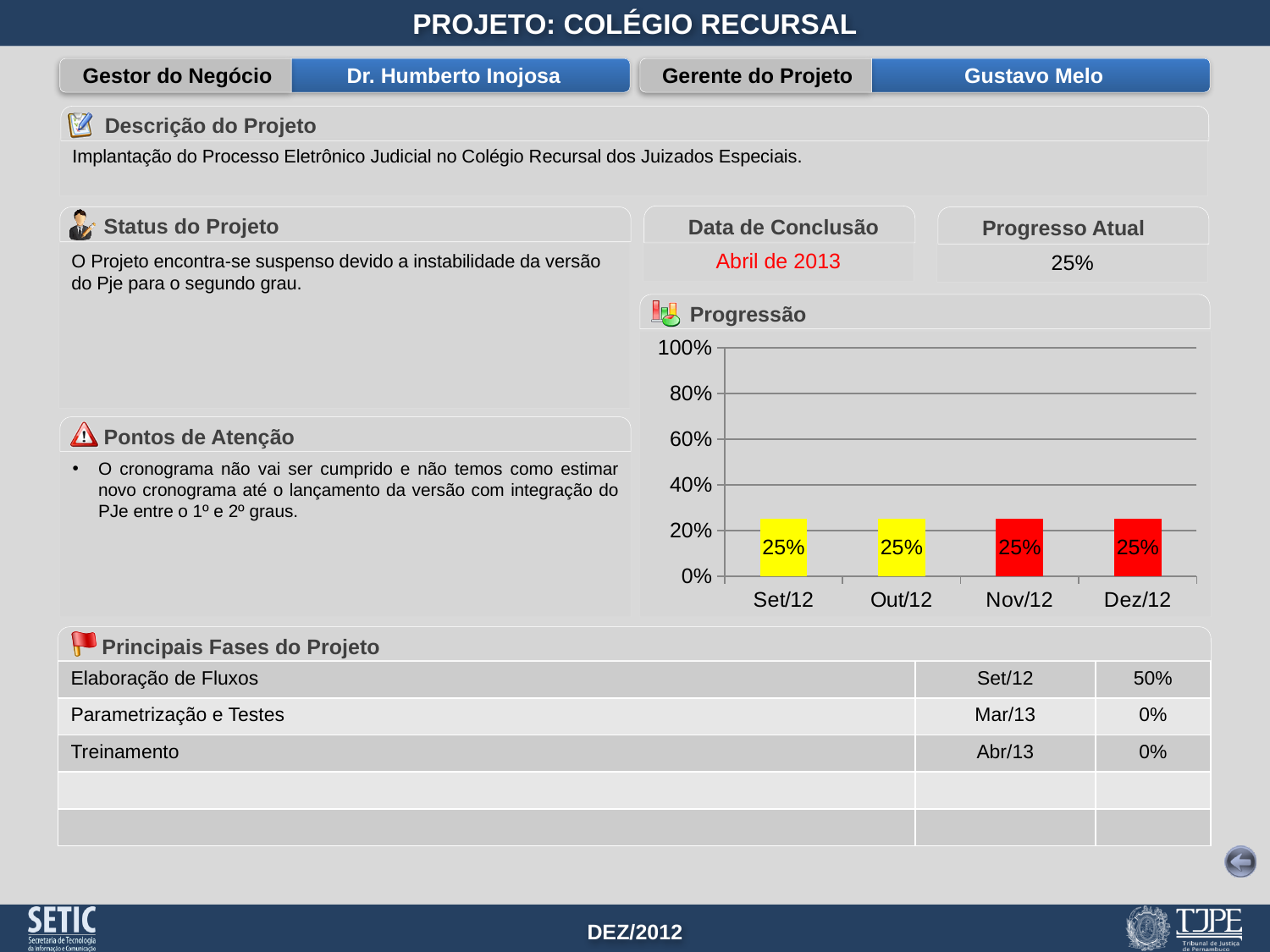
In the Progressão chart, what is the value for Dez/12? 25% In the Progressão chart, what colour are the bars for Nov/12 and Dez/12? red In the Progressão chart, which month is the first category on the horizontal axis? Set/12 What kind of chart is the Progressão chart? bar chart How many months are plotted in the Progressão chart? 4 In the Progressão chart, what is the value for Nov/12? 25% In the Progressão chart, what is the difference between the values for Dez/12 and Set/12? 0% In the Progressão chart, is the value for Nov/12 greater or less than 40%? less In the Progressão chart, do the values rise, fall or stay the same from Set/12 to Dez/12? stay the same In the Progressão chart, what is the highest value shown on the vertical axis? 100% In the Progressão chart, what is the value for Out/12? 25% In the Progressão chart, what is the value for Set/12? 25%